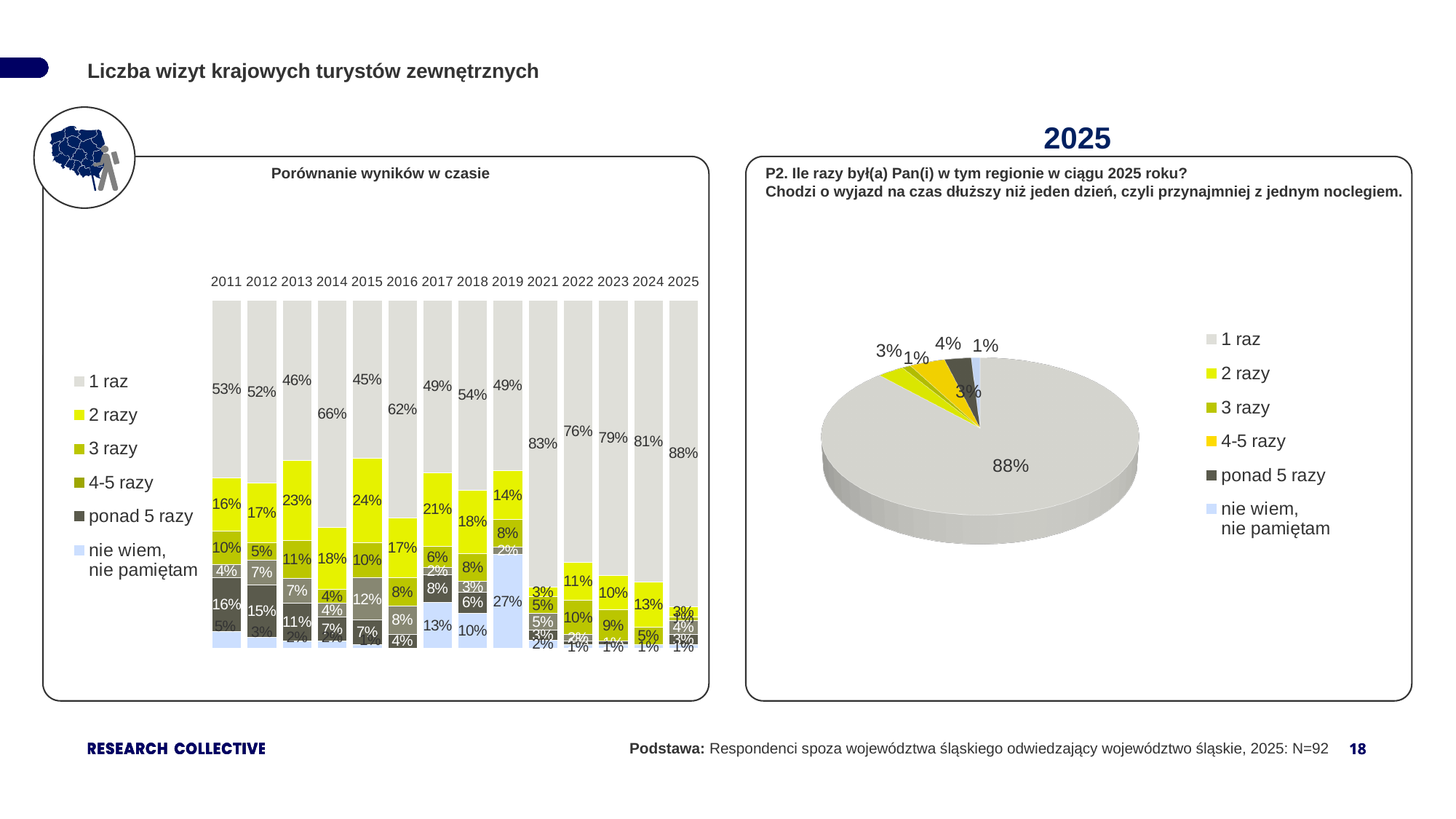
What kind of chart is 'Porównanie wyników w czasie'? Stacked bar chart In the pie chart on the right (2025), which category has the largest slice? 1 raz How many years (bars) are shown in the chart 'Porównanie wyników w czasie'? 14 In the chart 'Porównanie wyników w czasie', which year has the highest value for '1 raz'? 2025 In the chart 'Porównanie wyników w czasie', what is the value for '1 raz' in 2014? 66% In the chart 'Porównanie wyników w czasie', which year has the larger value for '2 razy': 2013 or 2019? 2013 What kind of chart is the chart on the right side of the slide? Pie chart In the chart 'Porównanie wyników w czasie', what is the difference between the '1 raz' value in 2025 and in 2011? 35 percentage points In the pie chart on the right (2025), what share of respondents answered '1 raz'? 88% In the pie chart on the right (2025), what is the value for '4-5 razy'? 4% How many entries does the legend of the pie chart on the right list? 6 In the chart 'Porównanie wyników w czasie', what is the value for '2 razy' in 2015? 24%